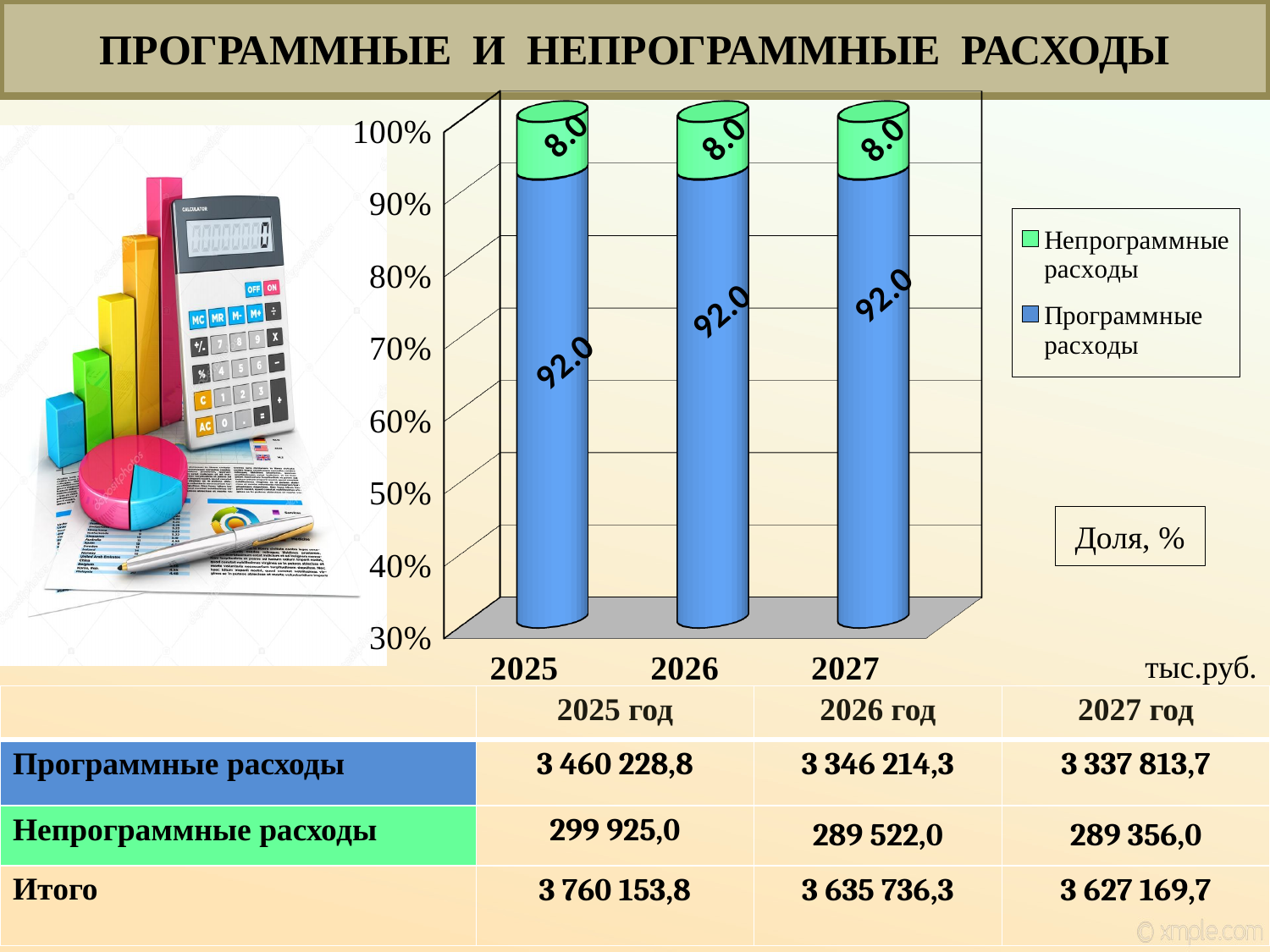
Does the share of Программные расходы change from 2025 to 2027 in the chart? No, it stays at 92.0 What is the total of the stacked bar for 2025? 100.0 What is the difference between the shares of Программные расходы and Непрограммные расходы in 2026? 84.0 How many series does the chart legend list? 2 What kind of chart is shown on the slide? bar chart Which legend entry is shown in green? Непрограммные расходы Which series has the larger share in 2027, Программные расходы or Непрограммные расходы? Программные расходы How many years are shown on the x axis of the chart? 3 What unit label is shown in the box to the right of the chart? Доля, % What is the share of Программные расходы in 2025 according to the chart? 92.0 What is the share of Непрограммные расходы in 2027 according to the chart? 8.0 What is the share of Непрограммные расходы in 2026 according to the chart? 8.0